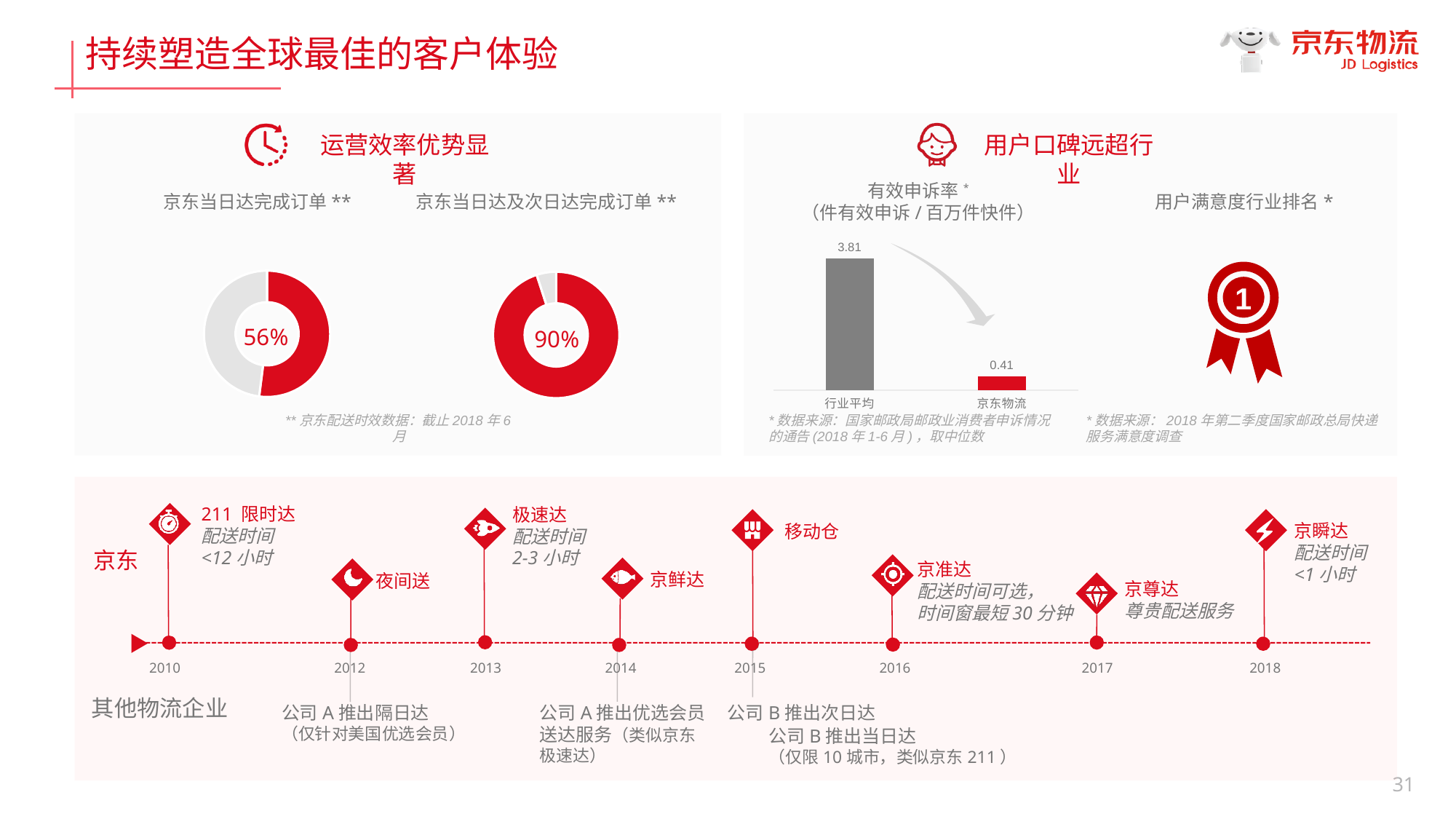
In the 京东当日达完成订单 donut chart, what percentage is shown? 56% Which of the two donut charts shows the higher percentage, 京东当日达完成订单 or 京东当日达及次日达完成订单? 京东当日达及次日达完成订单 In the 京东当日达及次日达完成订单 donut chart, what percentage is shown? 90% In the 有效申诉率 bar chart, what is the value for 行业平均? 3.81 In the 有效申诉率 bar chart, which is larger, 行业平均 or 京东物流? 行业平均 What kind of chart is the 有效申诉率 chart? bar chart What is the difference between the percentage in the 京东当日达及次日达完成订单 donut and the percentage in the 京东当日达完成订单 donut? 34% In the 有效申诉率 bar chart, what is the difference between the 行业平均 value and the 京东物流 value? 3.40 In the 有效申诉率 bar chart, what is the value for 京东物流? 0.41 In the 有效申诉率 bar chart, what colour is the 京东物流 bar? red In the 有效申诉率 bar chart, how many bars are plotted? 2 In the 有效申诉率 bar chart, which category has the lowest value? 京东物流